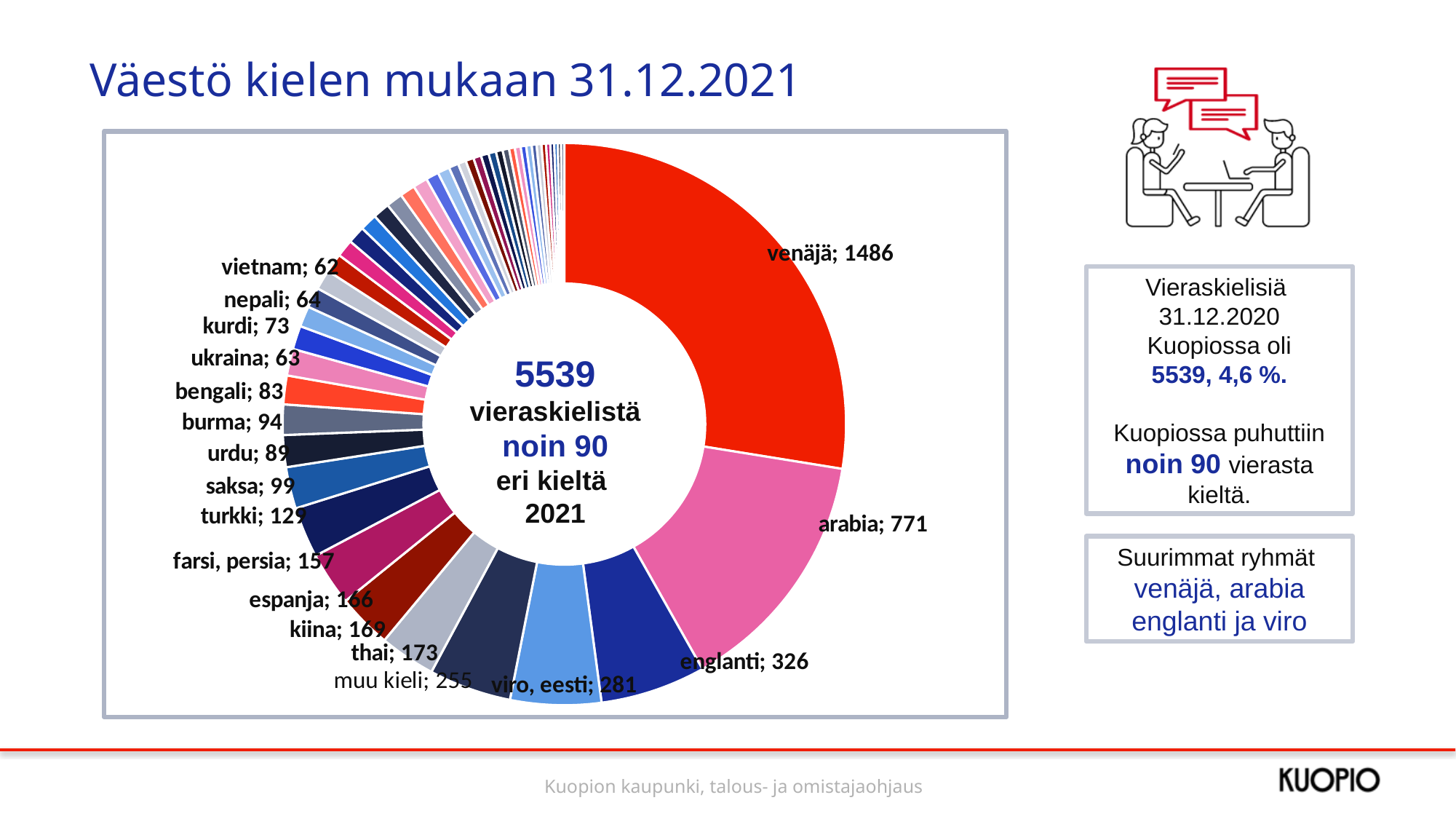
Which has a larger value, burma or urdu? burma What is the value for venäjä in the chart? 1486 Which language has the largest slice in the chart? venäjä Which has a larger value, kiina or espanja? kiina What is the value for turkki in the chart? 129 What is the difference between the values for venäjä and arabia? 715 What is the value for englanti in the chart? 326 What kind of chart is shown on the slide? pie chart (doughnut) What is the value for arabia in the chart? 771 What is the value for thai in the chart? 173 What is the difference between the values for englanti and viro, eesti? 45 What total number of foreign-language speakers is printed in the centre of the chart? 5539